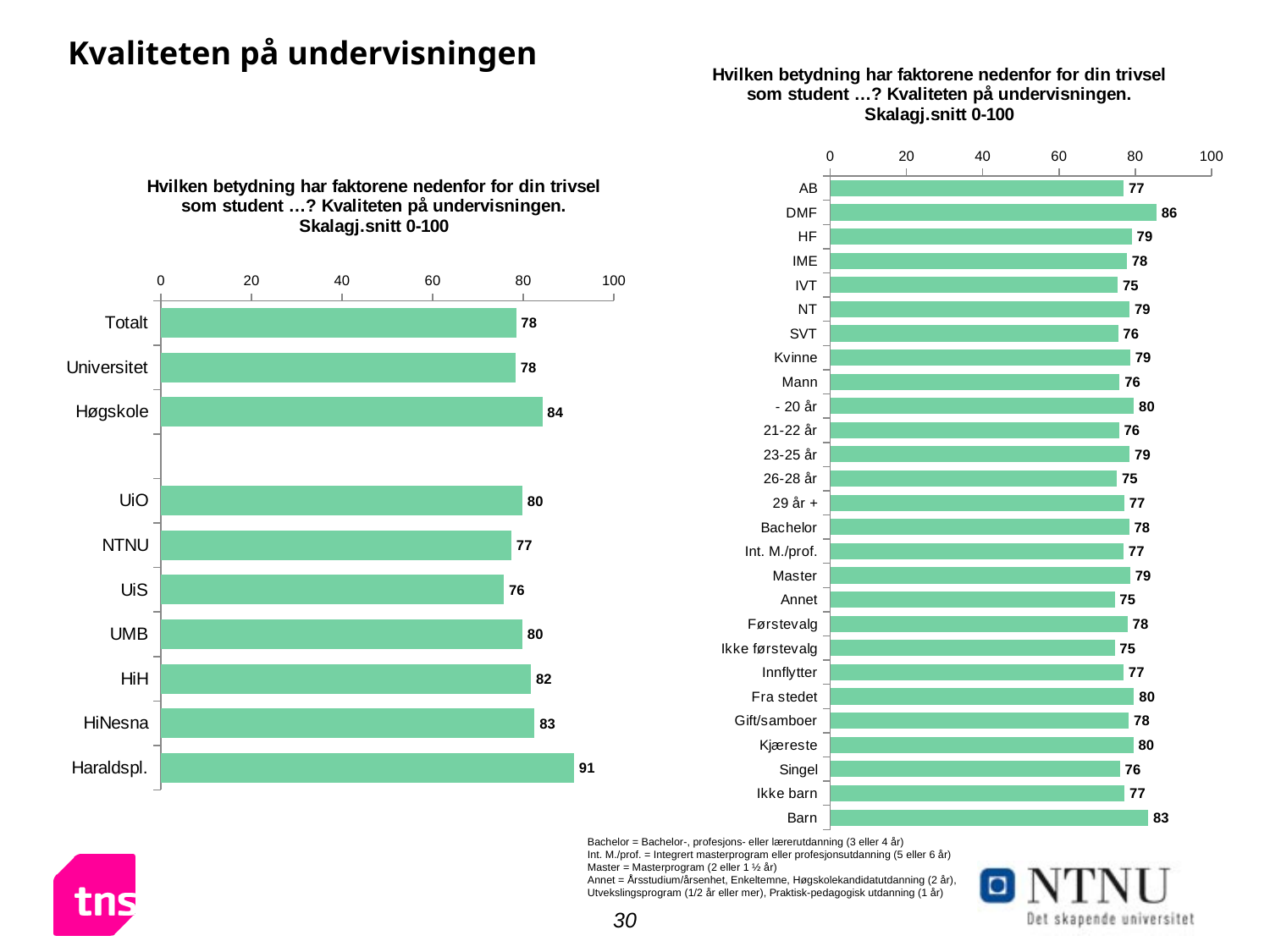
In the right chart, what is the difference between the values for Barn and Ikke barn? 6 In the left chart, which category has the lowest value? UiS In the left chart, which category has the highest value? Haraldspl. In the right chart, which category has the highest value? DMF In the left chart, what is the difference between the values for Haraldspl. and Totalt? 13 In the right chart, what is the value for Barn? 83 In the left chart, how many categories are plotted? 10 What type of chart is the left chart? Bar chart In the right chart, what is the value for DMF? 86 In the left chart, what is the value for Haraldspl.? 91 In the left chart, what is the value for Høgskole? 84 In the right chart, which is larger, the value for Kvinne or the value for Mann? Kvinne